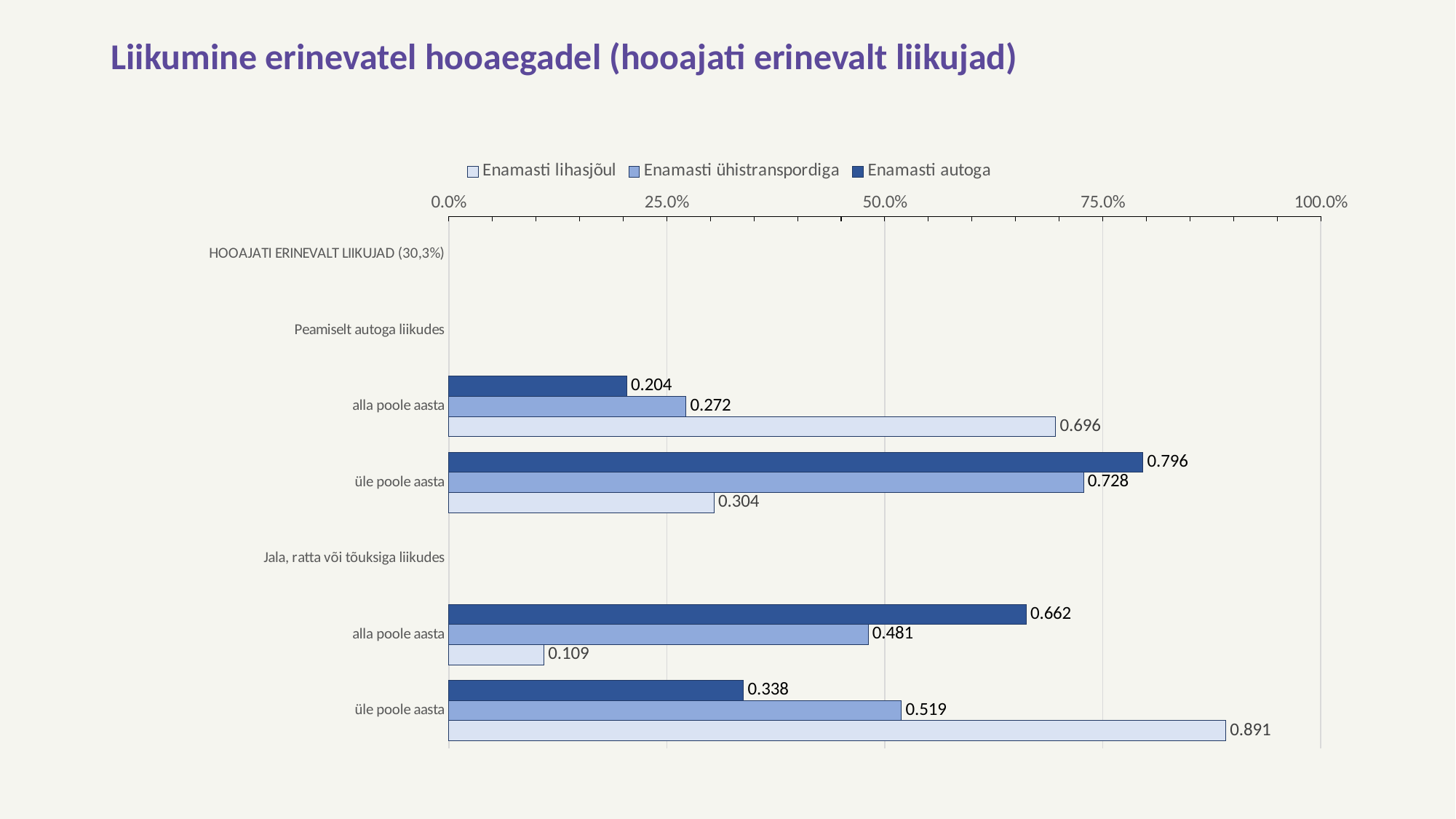
What is the value of 'Enamasti lihasjõul' for 'üle poole aasta' under 'Jala, ratta või tõuksiga liikudes'? 0.891 What is the value of 'Enamasti autoga' for 'üle poole aasta' under 'Peamiselt autoga liikudes'? 0.796 What is the value of 'Enamasti ühistranspordiga' for 'alla poole aasta' under 'Peamiselt autoga liikudes'? 0.272 What is the difference between the 'Enamasti autoga' and 'Enamasti ühistranspordiga' values for 'üle poole aasta' under 'Peamiselt autoga liikudes'? 0.068 Which is larger for 'alla poole aasta' under 'Jala, ratta või tõuksiga liikudes': 'Enamasti autoga' or 'Enamasti ühistranspordiga'? Enamasti autoga Which series has the lowest value for 'üle poole aasta' under 'Jala, ratta või tõuksiga liikudes'? Enamasti autoga What type of chart is shown on the slide? bar chart What is the title of the chart on the slide? Liikumine erinevatel hooaegadel (hooajati erinevalt liikujad) Which series has the highest value for 'alla poole aasta' under 'Peamiselt autoga liikudes'? Enamasti lihasjõul Is the 'Enamasti lihasjõul' value for 'üle poole aasta' under 'Peamiselt autoga liikudes' greater or less than 50.0%? less How many series does the legend list? 3 What is the value of 'Enamasti lihasjõul' for 'alla poole aasta' under 'Jala, ratta või tõuksiga liikudes'? 0.109